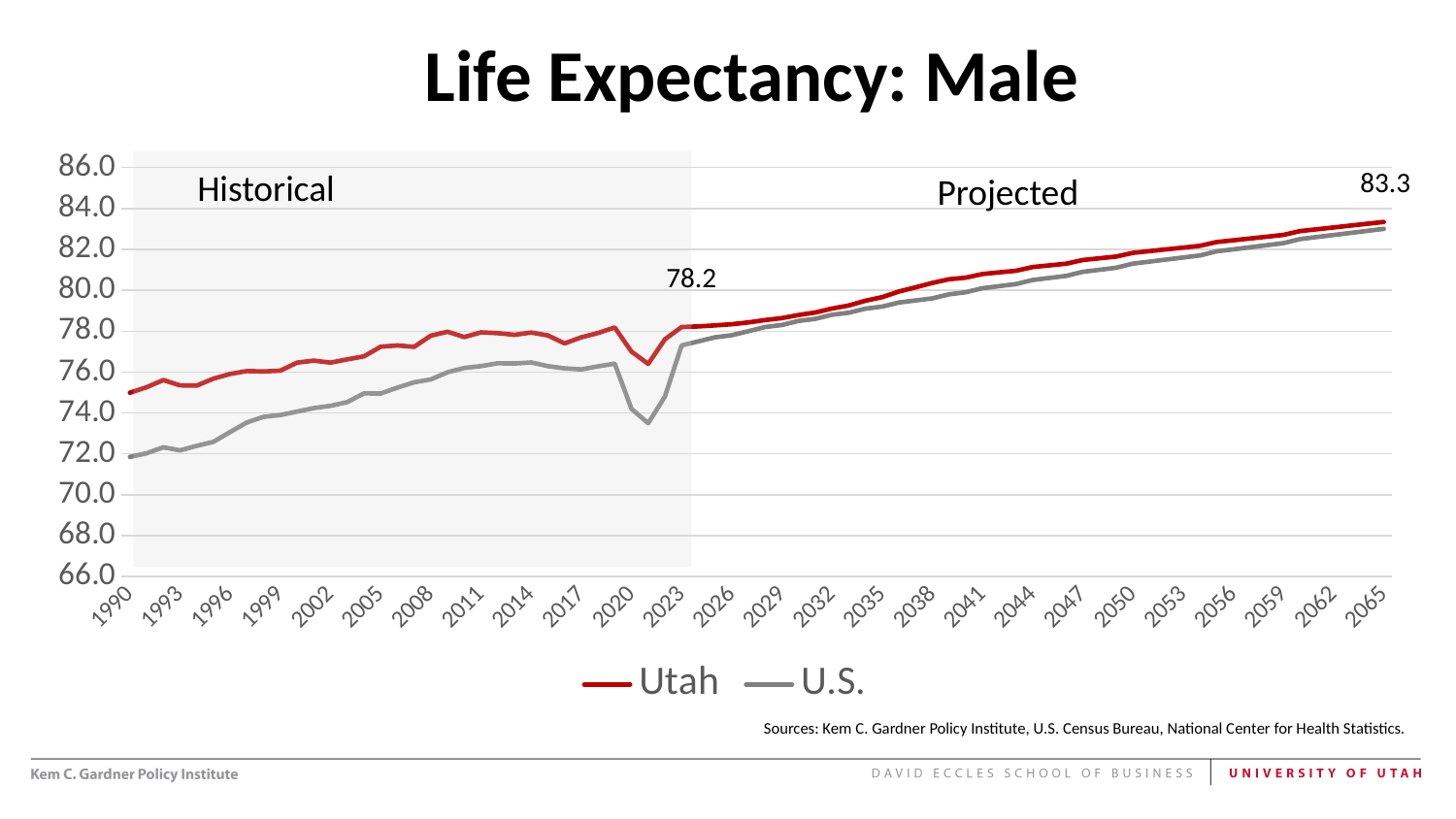
How many series does the legend list? 2 What value is labeled on the Utah line at the boundary between the Historical and Projected periods? 78.2 Is the value for the U.S. line in 2065 greater or less than 82.0? greater Which colour is used for the U.S. line? gray What is the difference between the two labeled values on the Utah line, 83.3 and 78.2? 5.1 Do the values on the Utah line generally rise or fall from 1990 to 2065? rise In which year does the Utah line reach its lowest value? 1990 What kind of chart is shown on the slide? line chart Is the value for the U.S. line at its dip around 2021 greater or less than 74.0? less Is the value for Utah in 1990 greater or less than 74.0? greater What value is labeled at the end of the Utah line in 2065? 83.3 Which series has the higher value in 1990, Utah or U.S.? Utah